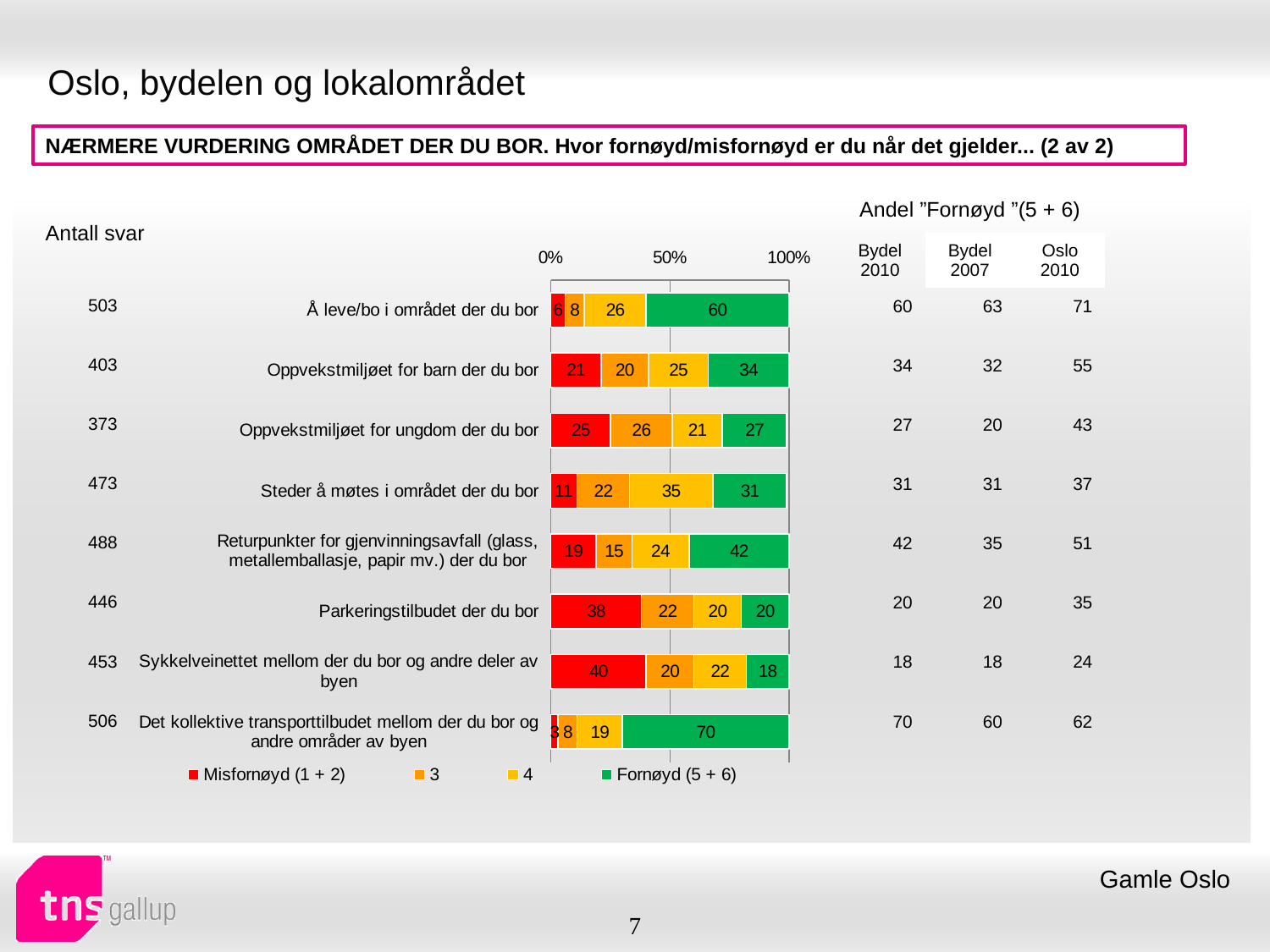
What colour represents the Fornøyd (5 + 6) series in the chart? Green What is the Misfornøyd (1 + 2) value for "Parkeringstilbudet der du bor"? 38 Which is larger: the Misfornøyd (1 + 2) value for "Oppvekstmiljøet for ungdom der du bor" or for "Oppvekstmiljøet for barn der du bor"? Oppvekstmiljøet for ungdom der du bor What kind of chart is shown on the slide? Stacked bar chart How many categories are shown in the chart? 8 How many series does the legend list? 4 Which category has the highest Misfornøyd (1 + 2) value? Sykkelveinettet mellom der du bor og andre deler av byen What is the value of series "4" for "Steder å møtes i området der du bor"? 35 What is the Fornøyd (5 + 6) value for "Å leve/bo i området der du bor"? 60 Which category has the lowest Fornøyd (5 + 6) value? Sykkelveinettet mellom der du bor og andre deler av byen What is the difference between the Fornøyd (5 + 6) values for "Returpunkter for gjenvinningsavfall" and "Oppvekstmiljøet for barn der du bor"? 8 Which category has the highest Fornøyd (5 + 6) value? Det kollektive transporttilbudet mellom der du bor og andre områder av byen